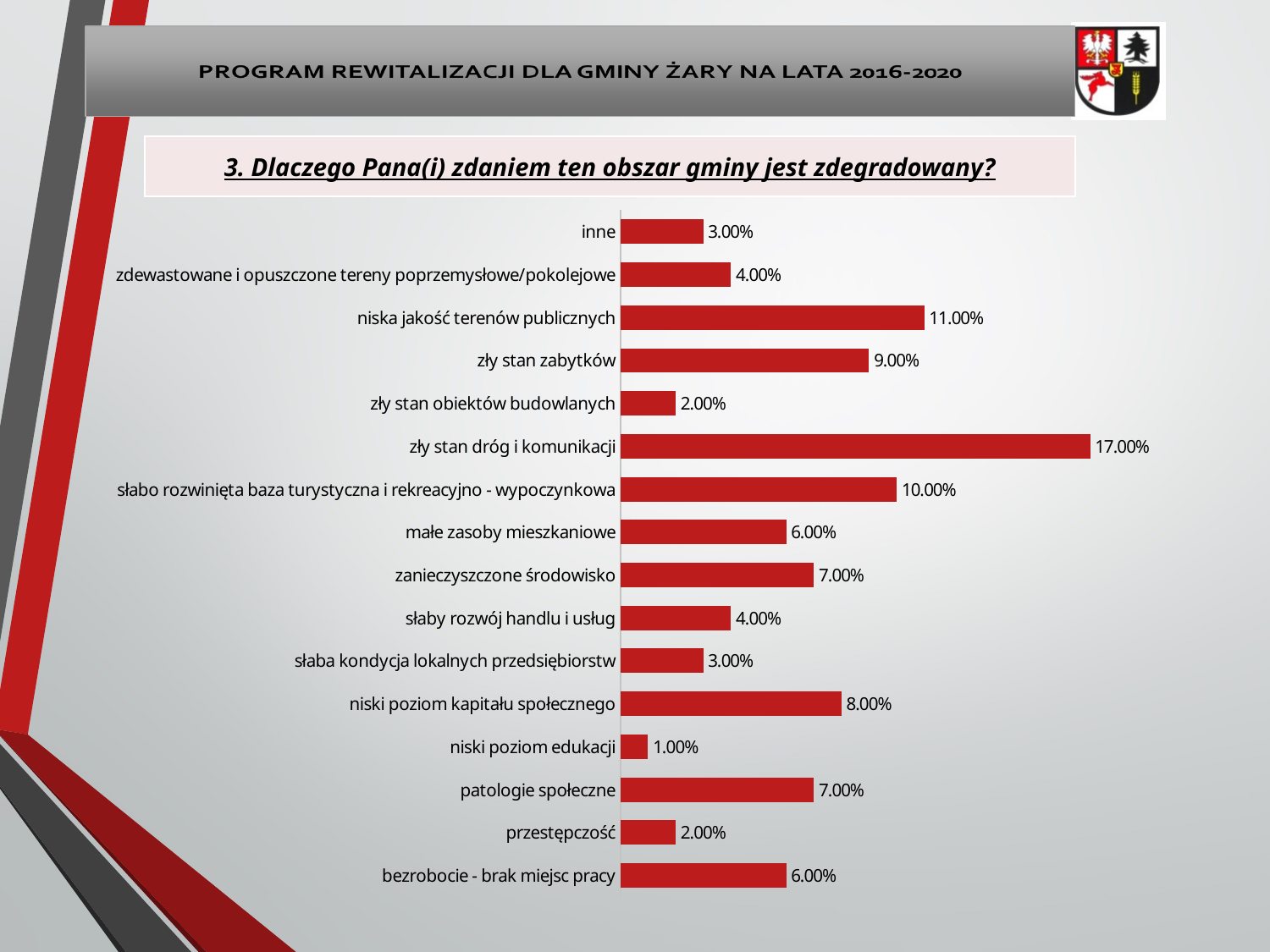
What kind of chart is shown on the slide? bar chart What is the value for "zły stan dróg i komunikacji"? 17.00% What is the value for "bezrobocie - brak miejsc pracy"? 6.00% How many categories are shown in the chart? 16 Which is larger: the value for "słabo rozwinięta baza turystyczna i rekreacyjno - wypoczynkowa" or the value for "zły stan zabytków"? słabo rozwinięta baza turystyczna i rekreacyjno - wypoczynkowa What is the difference between the values for "zły stan dróg i komunikacji" and "niska jakość terenów publicznych"? 6.00% Which category has the highest value? zły stan dróg i komunikacji What is the value for "niska jakość terenów publicznych"? 11.00% What is the difference between the values for "zły stan zabytków" and "zły stan obiektów budowlanych"? 7.00% What is the value for "niski poziom kapitału społecznego"? 8.00% What is the title of the chart? 3. Dlaczego Pana(i) zdaniem ten obszar gminy jest zdegradowany? Which category has the lowest value? niski poziom edukacji